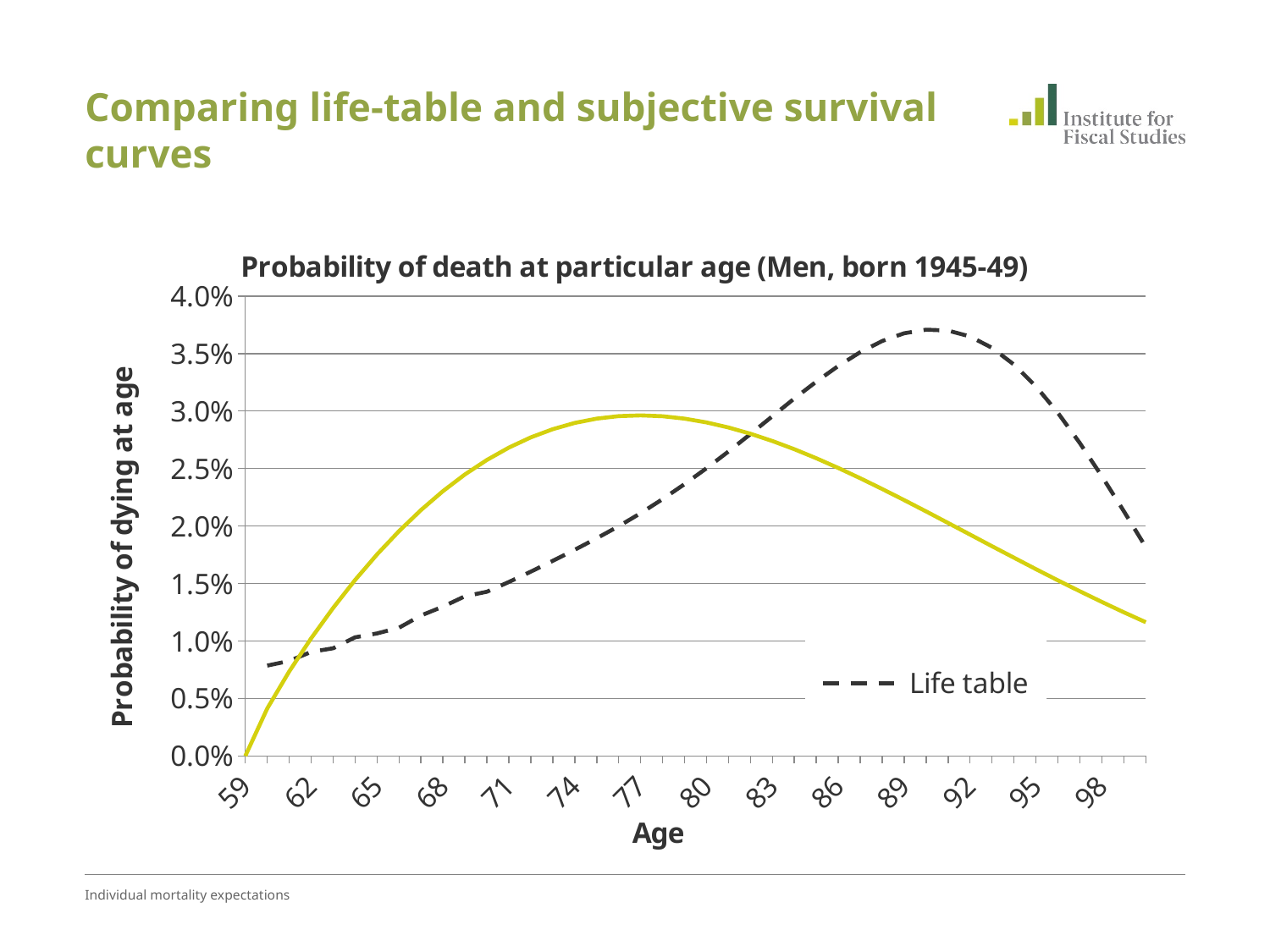
Is the Life table value at age 80 greater or less than 2.0%? greater At age 89, which is higher: the Life table line or the solid line? Life table What kind of chart is shown on the slide? Line chart Does the Life table line rise or fall between age 59 and age 89? rise Is the Life table value at age 89 greater or less than 3.5%? greater Is the value of the solid line at age 74 greater or less than 2.5%? greater What is the label on the vertical axis of the chart? Probability of dying at age How many age labels are shown along the x axis? 14 How many series does the chart's legend list? 1 What is the title of the chart? Probability of death at particular age (Men, born 1945-49)